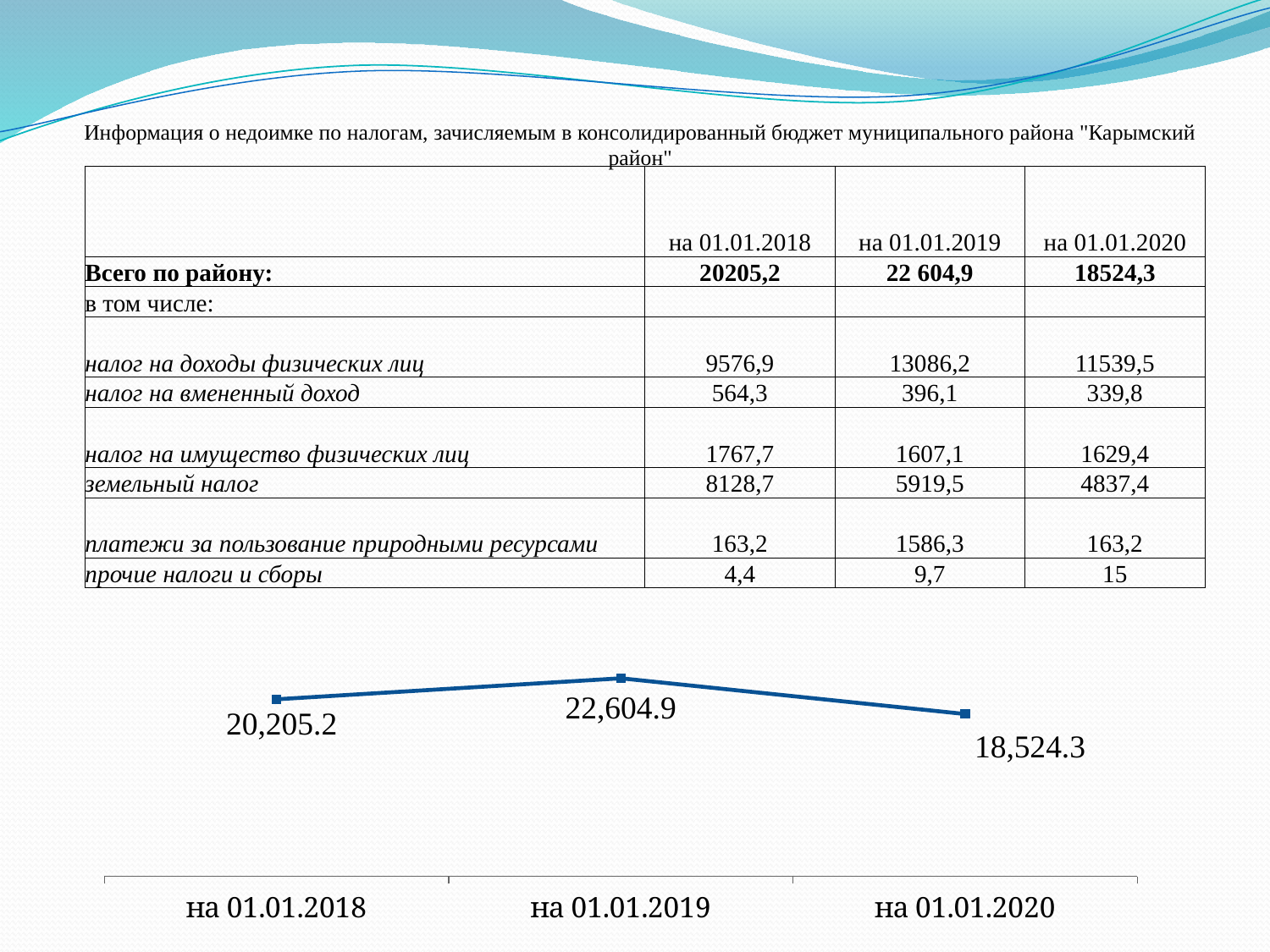
On the line chart, does the value rise or fall from на 01.01.2019 to на 01.01.2020? fall What is the value plotted for на 01.01.2020 on the line chart? 18,524.3 Which date has the highest value on the line chart? на 01.01.2019 On the line chart, which is larger: the value for на 01.01.2018 or the value for на 01.01.2020? на 01.01.2018 On the line chart, what is the difference between the values for на 01.01.2019 and на 01.01.2020? 4,080.6 What is the value plotted for на 01.01.2018 on the line chart? 20,205.2 Which date has the lowest value on the line chart? на 01.01.2020 On the line chart, what is the difference between the values for на 01.01.2019 and на 01.01.2018? 2,399.7 How many data points are plotted on the line chart? 3 What is the value plotted for на 01.01.2019 on the line chart? 22,604.9 What type of chart is shown at the bottom of the slide? line chart What colour is the line on the line chart? blue